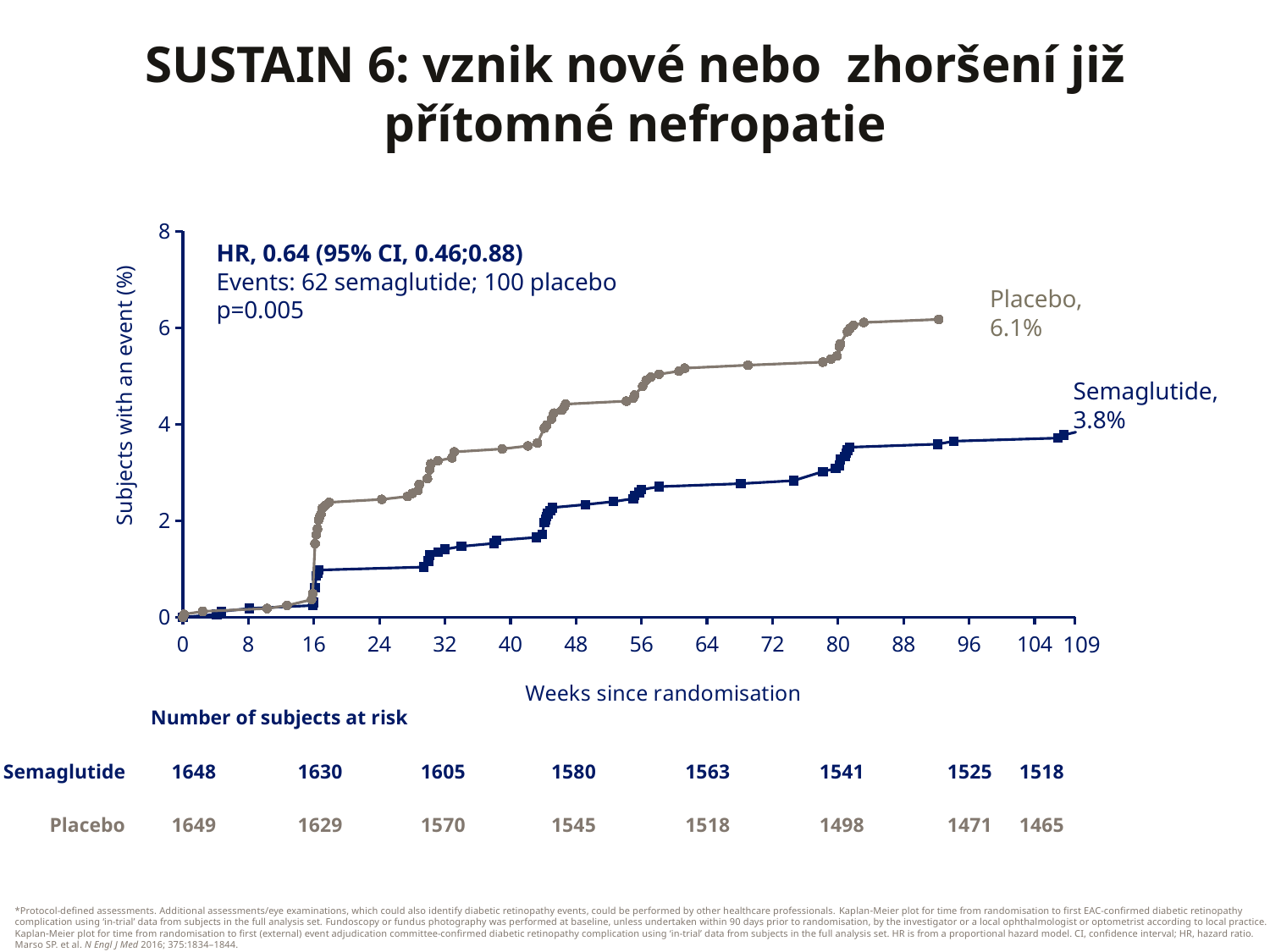
How many events are reported for placebo in the chart annotation? 100 What is the difference between the final Placebo and Semaglutide event percentages? 2.3% How many series are plotted on the chart? 2 What is the final percentage of subjects with an event for Placebo? 6.1% Is the Placebo value at week 56 greater or less than 4? greater What hazard ratio is printed on the chart? 0.64 (95% CI, 0.46;0.88) What is the final percentage of subjects with an event for Semaglutide? 3.8% Do the curves rise or fall as weeks since randomisation increase? rise What kind of chart is shown on the slide? line chart What is the label of the y-axis? Subjects with an event (%) Is the Semaglutide value at week 40 greater or less than 2? less Which series ends with the higher percentage of subjects with an event, Placebo or Semaglutide? Placebo